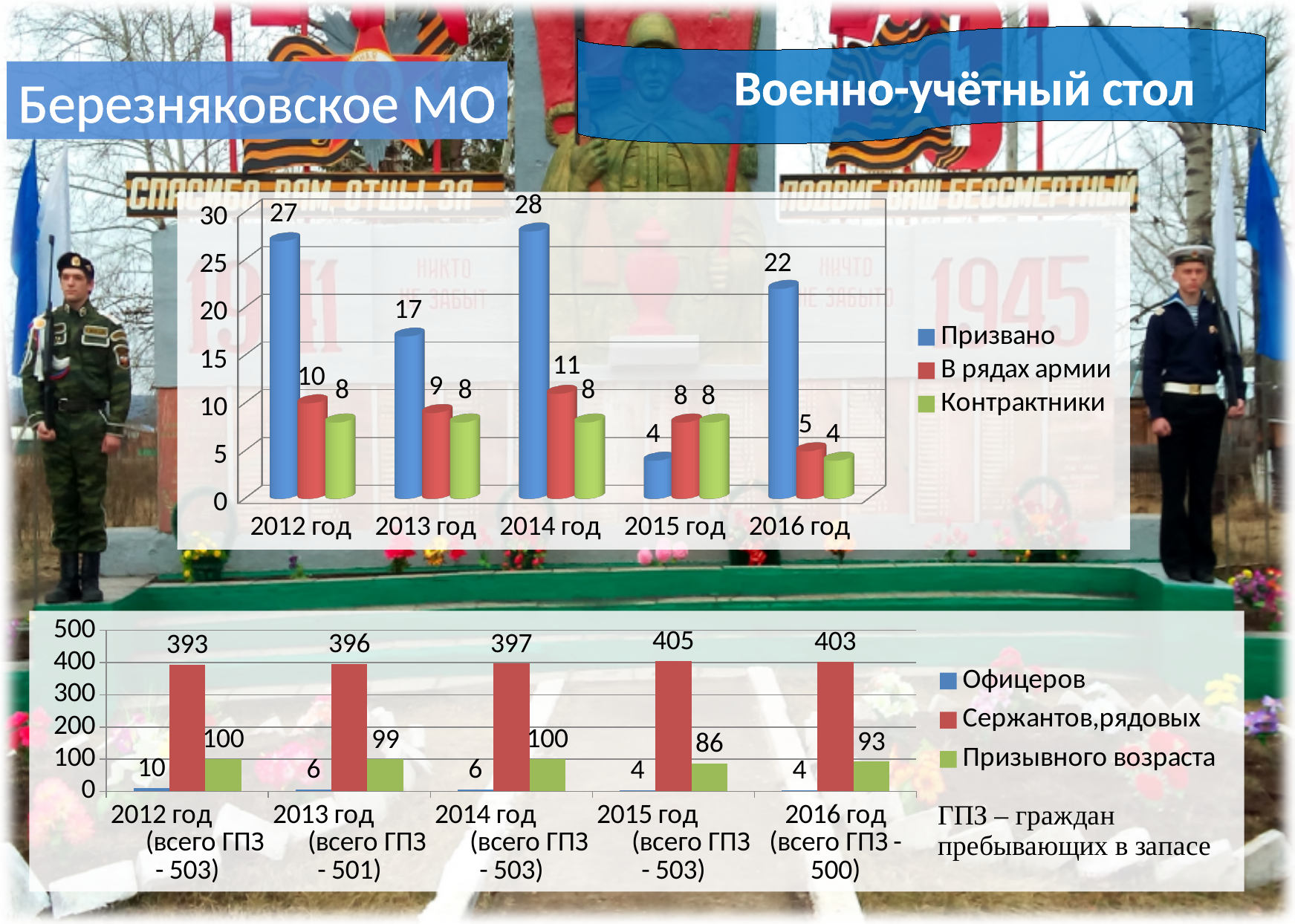
In the top chart, how many series does the legend list? 3 In the bottom chart, what is the difference between Призывного возраста in 2012 год and 2015 год? 14 In the top chart, which year has the lowest value for Призвано? 2015 год In the bottom chart, what is the value for Призывного возраста in 2016 год? 93 In the top chart, what is the value for В рядах армии in 2013 год? 9 In the top chart, what is the difference between Призвано and В рядах армии in 2012 год? 17 In the top chart, what is the value for Призвано in 2014 год? 28 In the top chart, which is larger in 2016 год: В рядах армии or Контрактники? В рядах армии In the bottom chart, how many years are shown on the x axis? 5 In the bottom chart, what is the value for Сержантов,рядовых in 2015 год? 405 In the bottom chart, which year has the highest value for Сержантов,рядовых? 2015 год What kind of chart is the bottom chart? bar chart